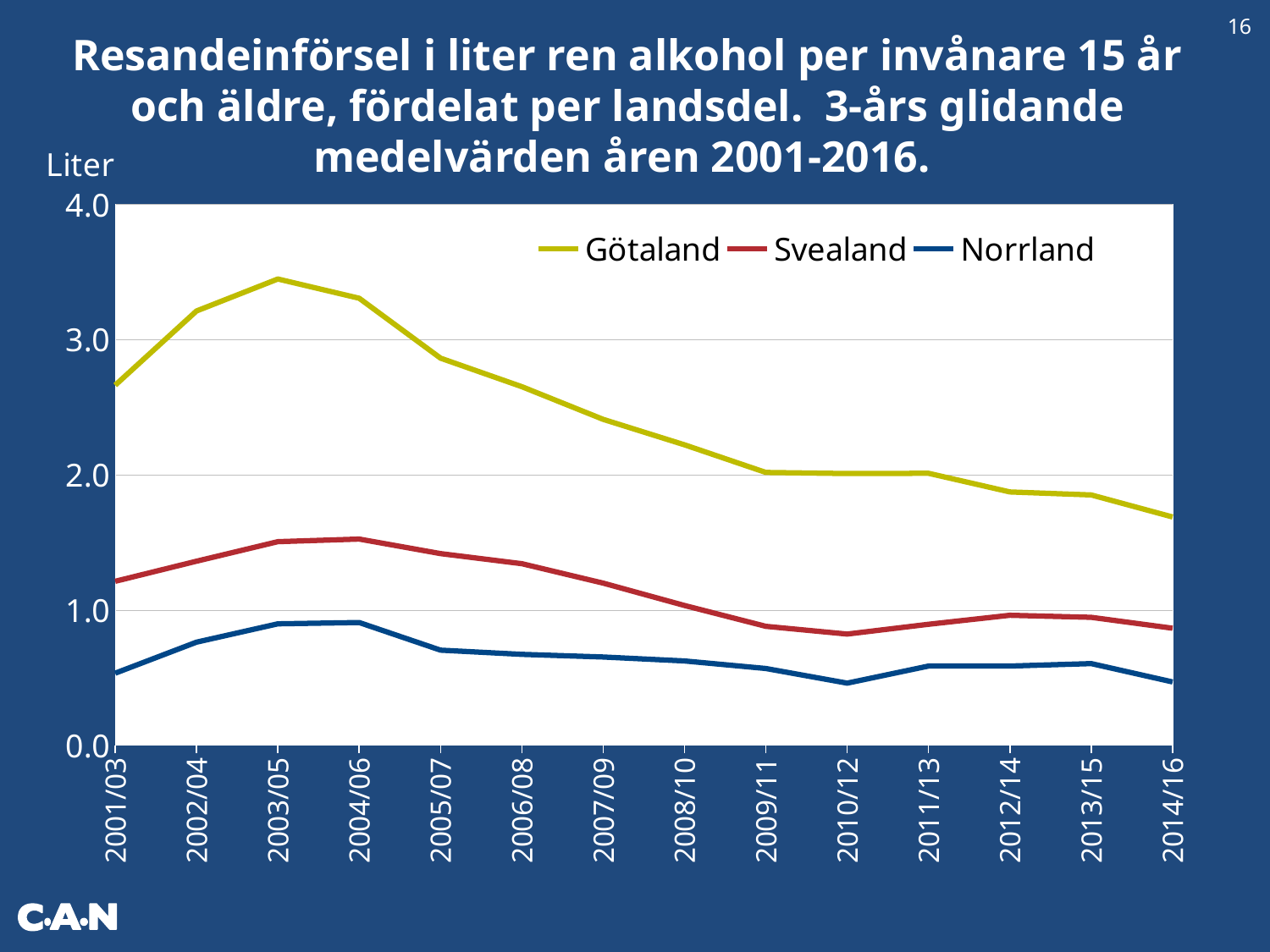
How many periods are shown along the x axis? 14 Which is larger in 2014/16, the value for Svealand or the value for Norrland? Svealand Does the Götaland line rise or fall from 2004/06 to 2014/16? fall In which period does the Götaland line reach its highest value? 2003/05 How many series does the legend list? 3 Is the value for Götaland in 2014/16 greater or less than 2.0? less What kind of chart is shown on the slide? line chart Which series has the lowest value in 2001/03? Norrland Is the value for Götaland in 2003/05 greater or less than 3.0? greater What unit is shown on the y axis label? Liter Which series has the highest value in 2003/05? Götaland Is the value for Norrland in 2010/12 greater or less than 1.0? less